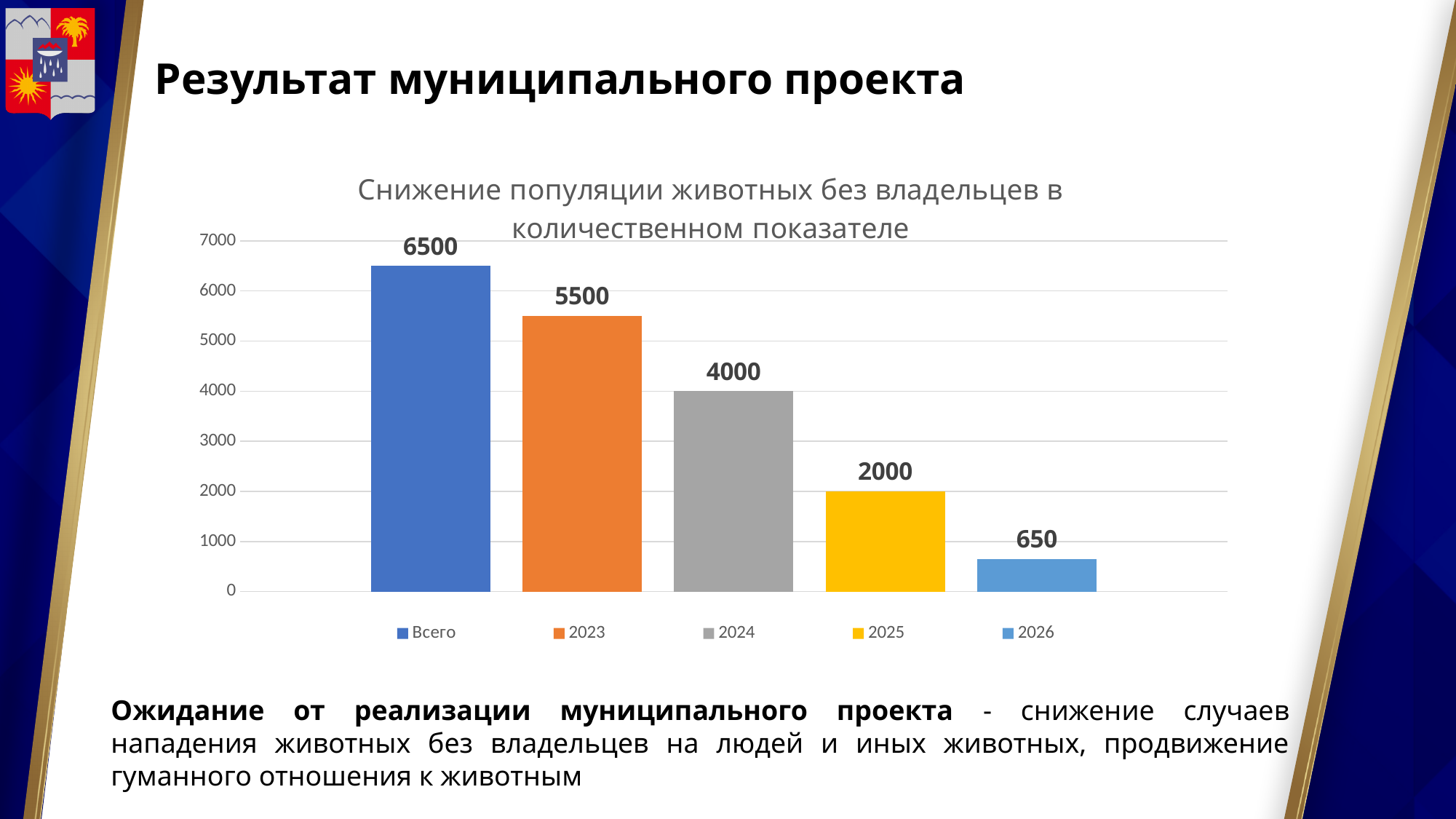
Do the values rise or fall from left to right across the chart? fall What is the value for 2026? 650 What kind of chart is shown on the slide? bar chart What is the value for Всего? 6500 What is the value for 2023? 5500 Which category has the highest value? Всего What is the difference between the values for 2023 and 2024? 1500 Which category has the lowest value? 2026 How many bars are shown in the chart? 5 What is the value for 2024? 4000 What is the difference between the values for 2025 and 2026? 1350 Which is larger, the value for 2024 or the value for 2025? 2024